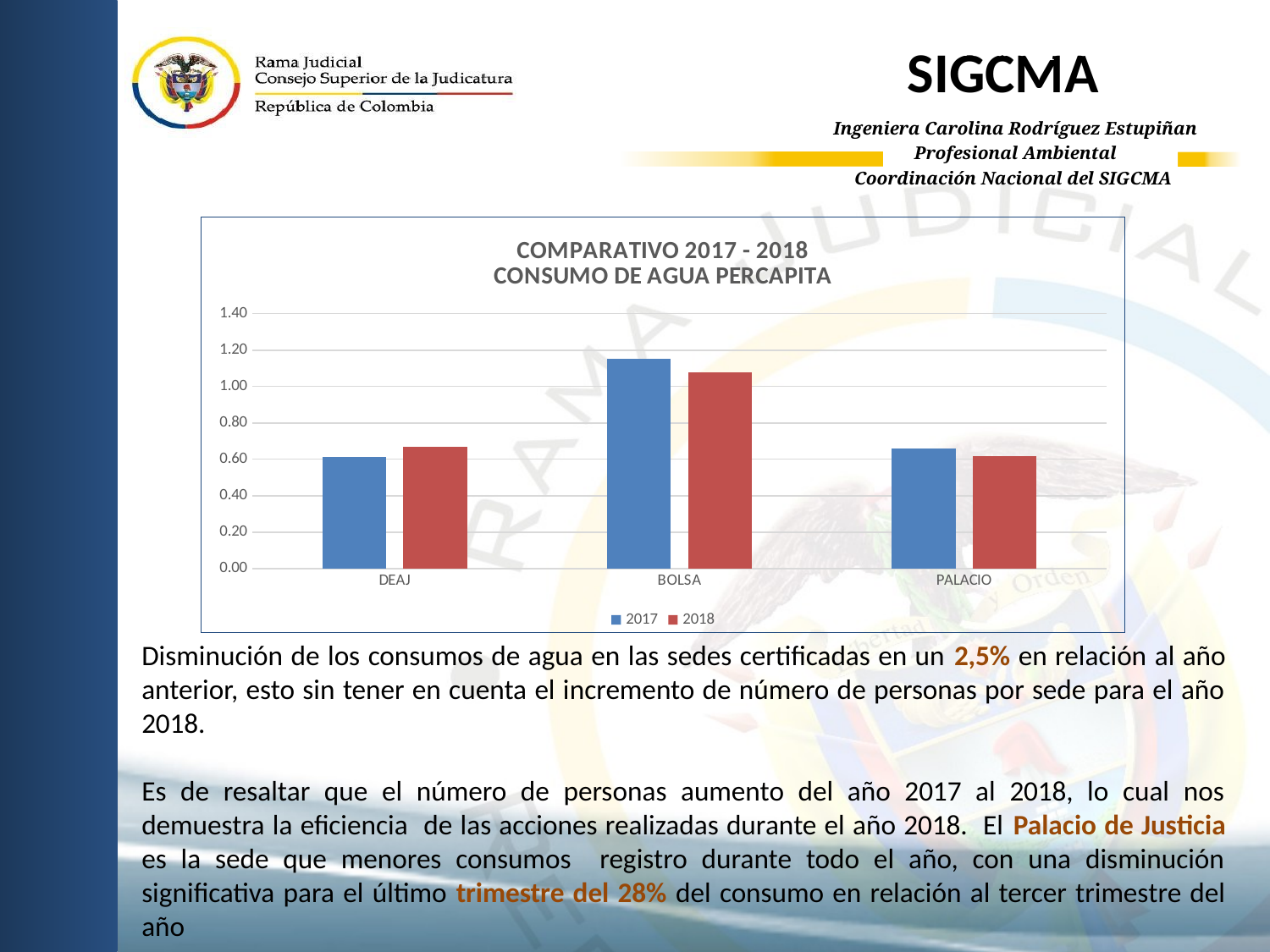
For BOLSA, which year has the larger value, 2017 or 2018? 2017 How many series does the chart legend list? 2 Is the 2017 value for DEAJ greater or less than 0.80? less What is the title of the chart? COMPARATIVO 2017 - 2018 CONSUMO DE AGUA PERCAPITA Is the 2017 value for BOLSA greater or less than 1.00? greater Which colour represents the 2018 series in the chart? red Which category has the highest 2017 value in the chart? BOLSA Which category has the highest 2018 value in the chart? BOLSA What kind of chart is shown on the slide? bar chart Is the 2018 value for PALACIO greater or less than 0.40? greater How many categories (sedes) are shown on the x axis of the chart? 3 For DEAJ, which year has the larger value, 2017 or 2018? 2018